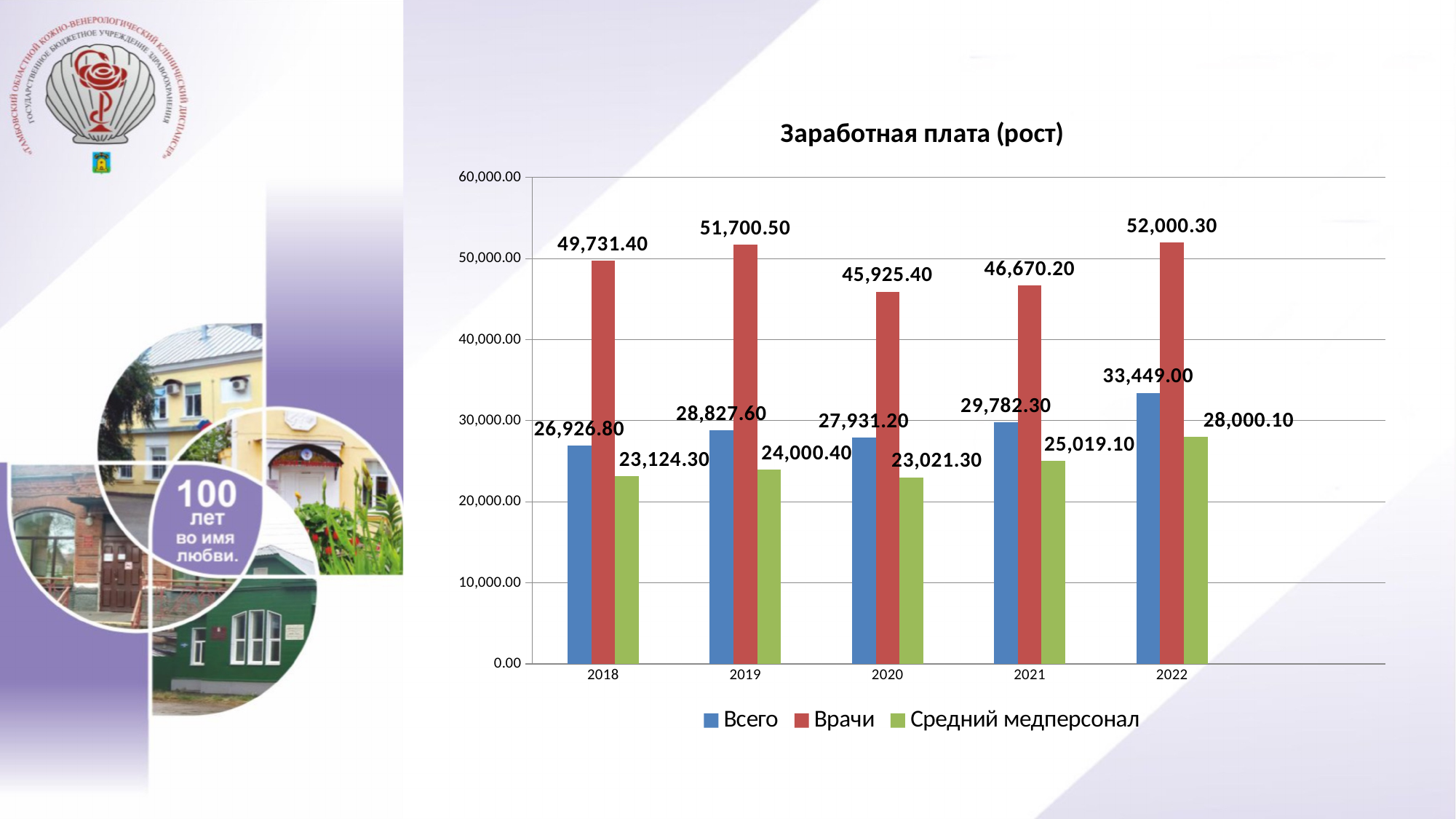
In which year is the value for Врачи the highest? 2022 What is the title of the chart? Заработная плата (рост) How many series does the legend list? 3 What is the value for Средний медперсонал in 2020? 23,021.30 Which is larger in 2020: the value for Всего or the value for Средний медперсонал? Всего What is the value for Всего in 2022? 33,449.00 How many years are shown on the x axis? 5 What is the value for Врачи in 2019? 51,700.50 By how much did the Всего value increase from 2021 to 2022? 3,666.70 Is the value for Врачи in 2020 greater or less than 50,000.00? less What is the difference between the Врачи values for 2022 and 2018? 2,268.90 In which year is the value for Средний медперсонал the lowest? 2020